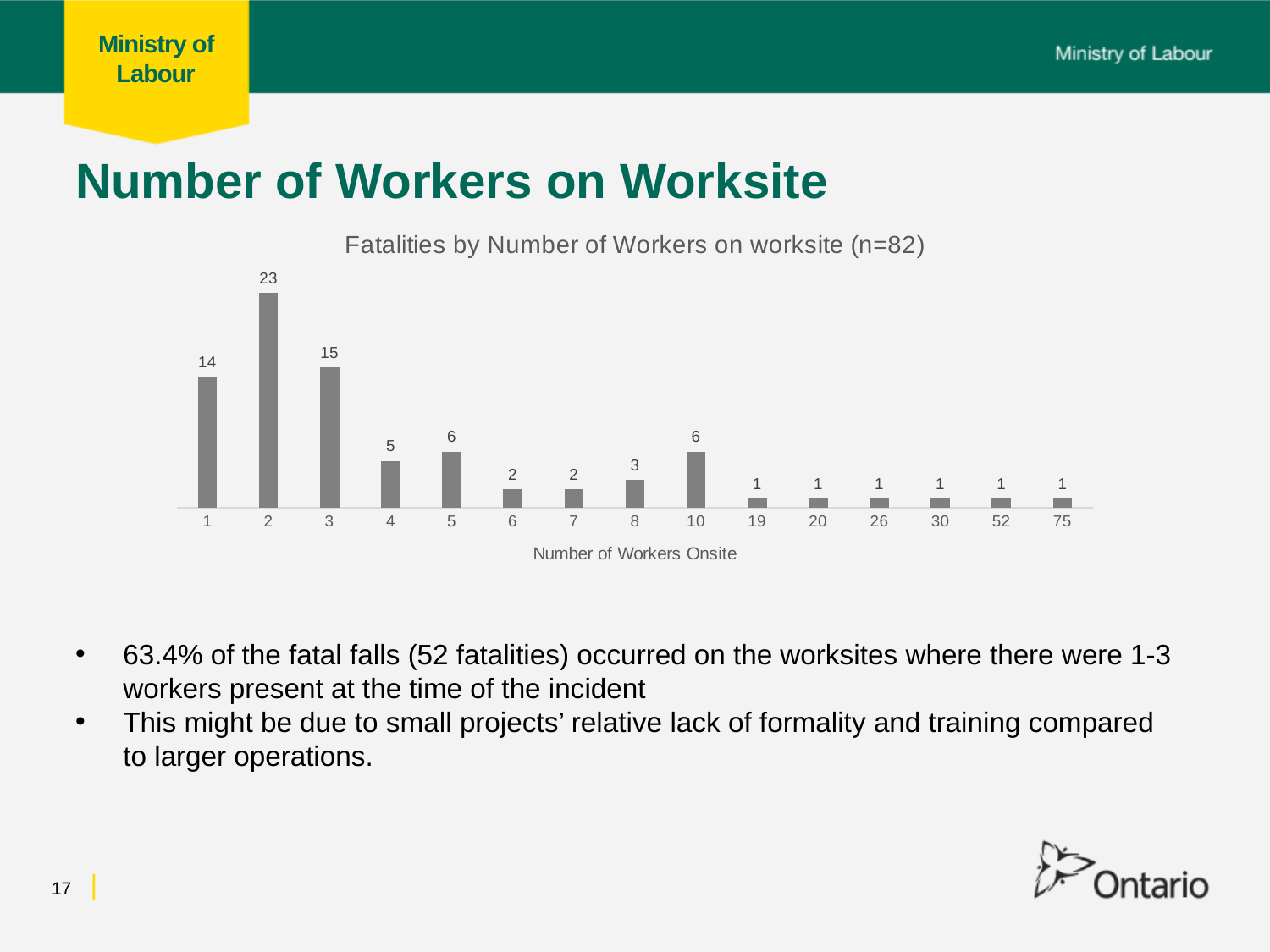
What is the number of fatalities for worksites with 2 workers onsite? 23 What is the total number of fatalities for worksites with 1, 2 and 3 workers combined? 52 What is the label of the x axis? Number of Workers Onsite What is the number of fatalities for worksites with 10 workers onsite? 6 Which has more fatalities: worksites with 5 workers or worksites with 8 workers? 5 workers Which number of workers onsite has the highest number of fatalities? 2 What is the number of fatalities for worksites with 3 workers onsite? 15 What kind of chart is shown on the slide? Bar chart What is the title of the chart? Fatalities by Number of Workers on worksite (n=82) How many categories of number of workers onsite are shown on the x axis? 15 What is the difference in fatalities between worksites with 3 workers and worksites with 4 workers? 10 What is the difference in fatalities between worksites with 2 workers and worksites with 1 worker? 9